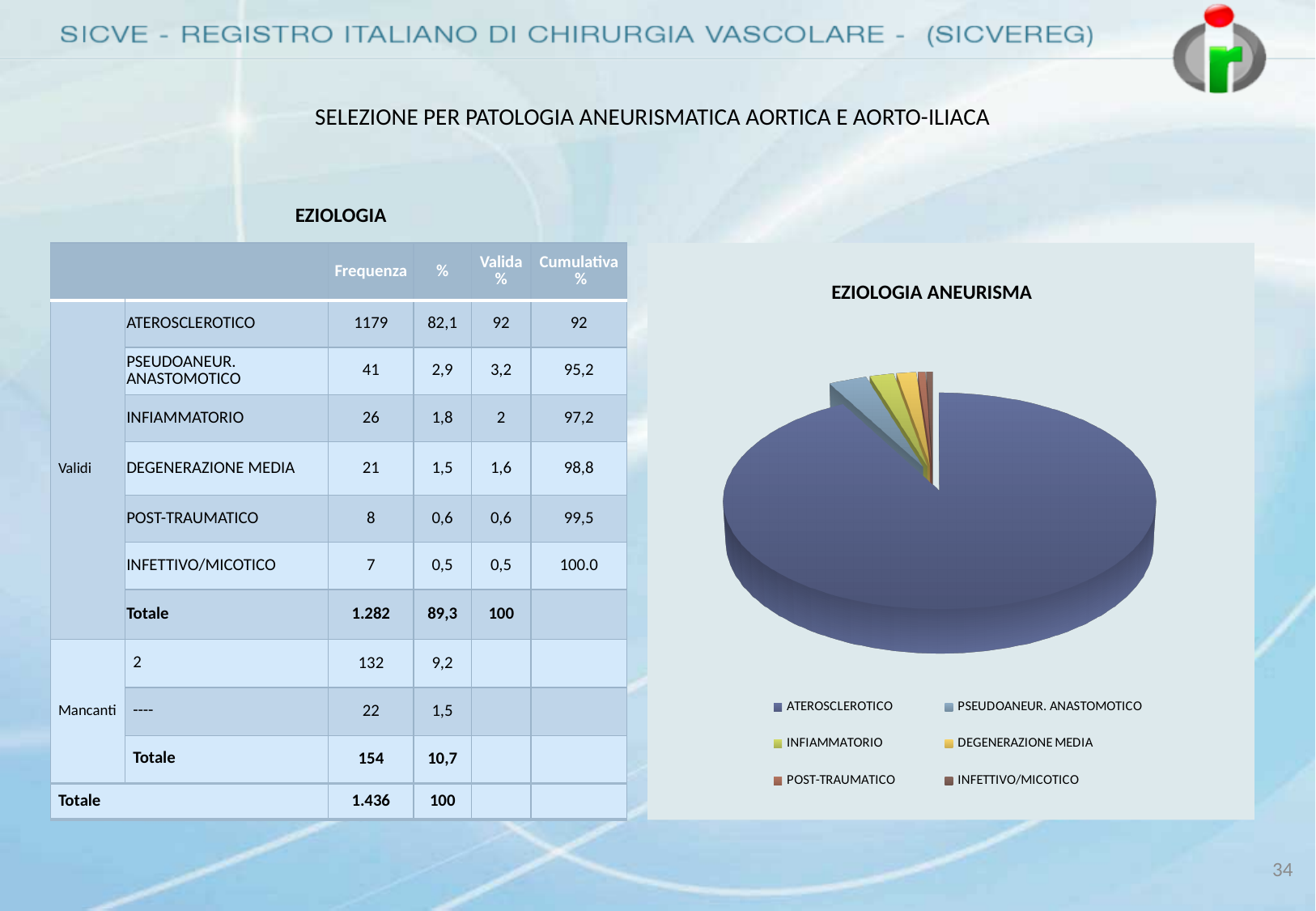
In the EZIOLOGIA ANEURISMA pie chart, which slice is larger: ATEROSCLEROTICO or PSEUDOANEUR. ANASTOMOTICO? ATEROSCLEROTICO Which category has the largest slice in the EZIOLOGIA ANEURISMA pie chart? ATEROSCLEROTICO How many categories does the legend of the EZIOLOGIA ANEURISMA pie chart list? 6 According to the EZIOLOGIA table, what is the Frequenza for ATEROSCLEROTICO? 1179 According to the EZIOLOGIA table, what is the Frequenza for INFIAMMATORIO? 26 Which category is shown in dark blue in the EZIOLOGIA ANEURISMA pie chart? ATEROSCLEROTICO What kind of chart is the EZIOLOGIA ANEURISMA chart? pie chart According to the EZIOLOGIA table, which etiology has the lowest Frequenza? INFETTIVO/MICOTICO What is the title of the pie chart on the slide? EZIOLOGIA ANEURISMA According to the EZIOLOGIA table, what is the Totale Frequenza of the Validi cases? 1.282 According to the EZIOLOGIA table, what is the Valida % share of ATEROSCLEROTICO? 92 According to the EZIOLOGIA table, what is the difference in Frequenza between ATEROSCLEROTICO and PSEUDOANEUR. ANASTOMOTICO? 1138